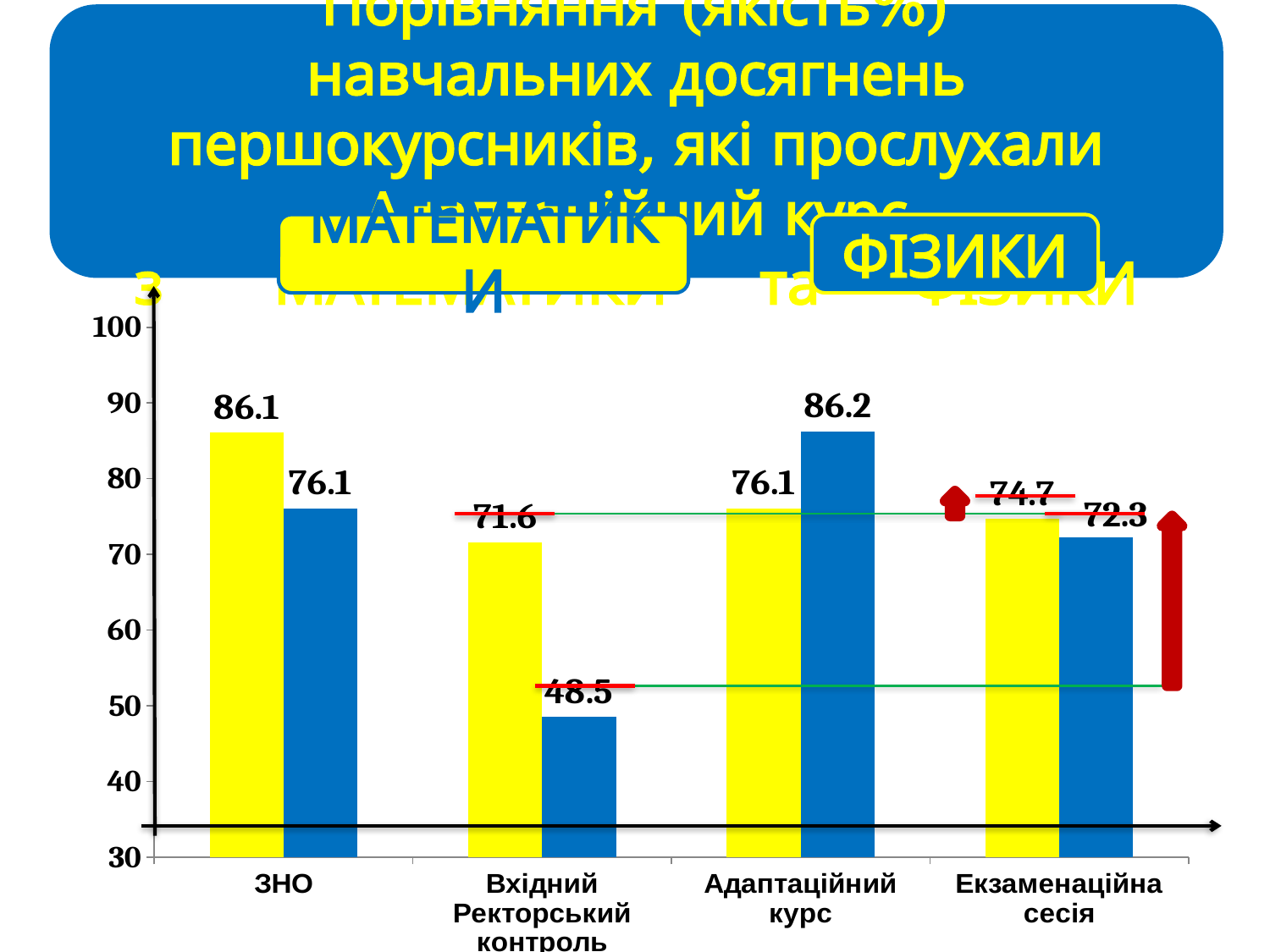
Which category has the lowest blue bar? Вхідний Ректорський контроль Is the value of the blue bar for ЗНО greater or less than 70? greater What is the value of the yellow bar for Екзаменаційна сесія? 74.7 What is the value of the blue bar for Адаптаційний курс? 86.2 What is the value of the yellow bar for ЗНО? 86.1 What is the value of the blue bar for Вхідний Ректорський контроль? 48.5 Which two subjects are named in the boxes above the chart? МАТЕМАТИКИ and ФІЗИКИ How many categories are shown along the x axis of the chart? 4 What type of chart is shown on the slide? bar chart Which is larger for Адаптаційний курс, the yellow bar or the blue bar? the blue bar What is the difference between the yellow and blue bars for Вхідний Ректорський контроль? 23.1 Which category has the highest yellow bar? ЗНО